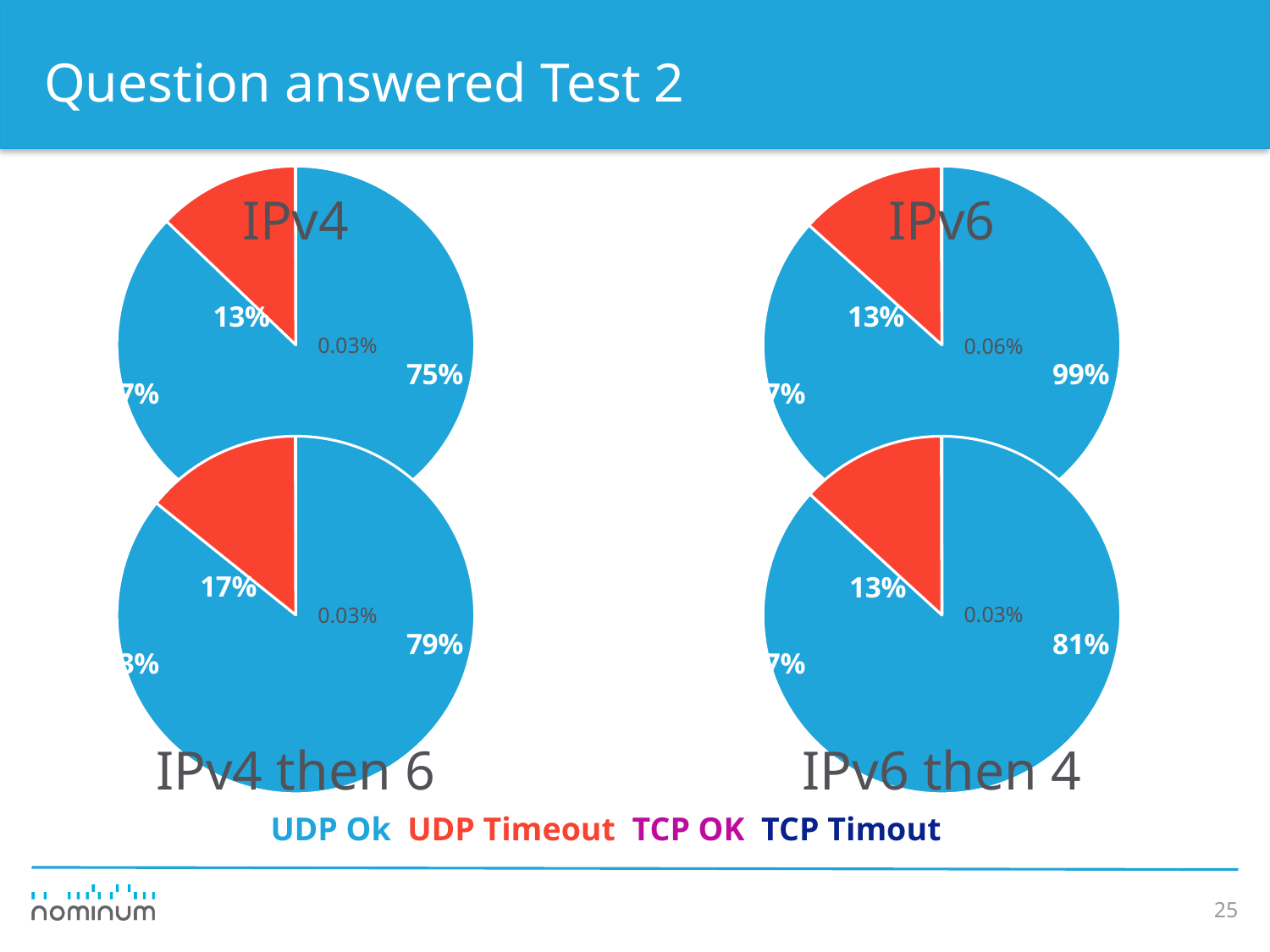
In the IPv6 then 4 pie chart, what percentage is shown for the UDP Timeout (red) slice? 13% Which has a larger UDP Timeout (red) slice: the IPv4 then 6 pie chart or the IPv6 then 4 pie chart? IPv4 then 6 In the IPv4 then 6 pie chart, what percentage is shown for the UDP Timeout (red) slice? 17% In the IPv4 pie chart, what percentage is shown for the UDP Timeout (red) slice? 13% In the IPv4 pie chart, what is the smallest percentage label printed? 0.03% In the IPv4 then 6 pie chart, what is the largest percentage label printed? 79% In the IPv6 pie chart, what is the smallest percentage label printed? 0.06% What is the difference between the UDP Timeout percentages in the IPv4 then 6 pie chart (17%) and the IPv4 pie chart (13%)? 4% In the IPv4 pie chart, what is the largest percentage label printed? 75% In the IPv6 then 4 pie chart, what is the largest percentage label printed? 81% How many entries does the legend at the bottom of the slide list? 4 How many pie charts are shown on the slide? 4